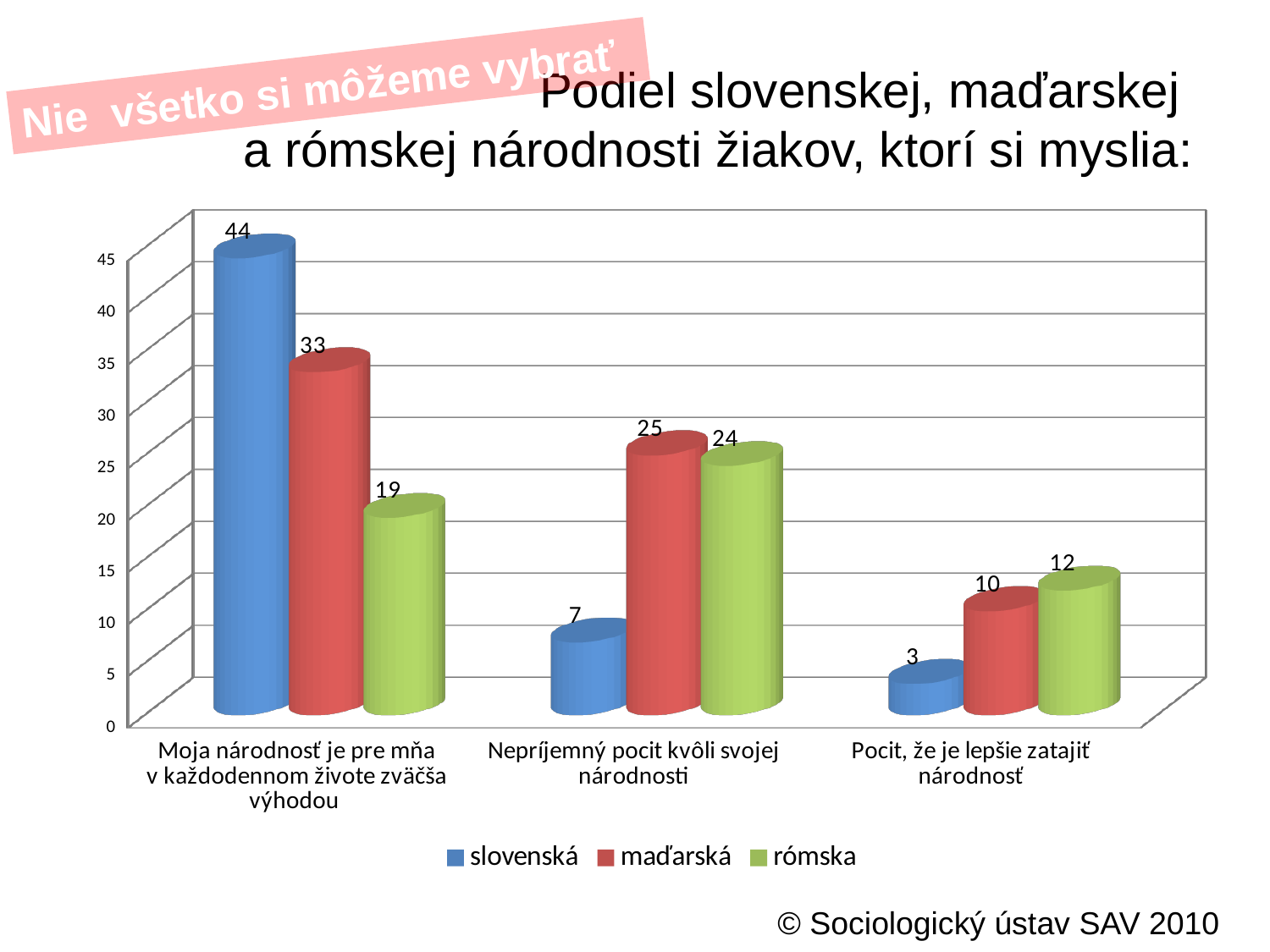
What is the difference between the slovenská and rómska values in the category 'Moja národnosť je pre mňa v každodennom živote zväčša výhodou'? 25 Which series has the lowest value in the category 'Pocit, že je lepšie zatajiť národnosť'? slovenská What value is shown for maďarská in the category 'Pocit, že je lepšie zatajiť národnosť'? 10 Which is larger: the rómska value for 'Pocit, že je lepšie zatajiť národnosť' or the slovenská value for 'Nepríjemný pocit kvôli svojej národnosti'? rómska value for 'Pocit, že je lepšie zatajiť národnosť' Which colour represents the maďarská series in the chart? red What kind of chart is shown on the slide? bar chart What value is shown for slovenská in the category 'Moja národnosť je pre mňa v každodennom živote zväčša výhodou'? 44 How many series does the legend list? 3 How many categories are shown on the x axis? 3 What value is shown for rómska in the category 'Nepríjemný pocit kvôli svojej národnosti'? 24 What is the difference between the maďarská and slovenská values in the category 'Nepríjemný pocit kvôli svojej národnosti'? 18 Which series has the highest value in the category 'Moja národnosť je pre mňa v každodennom živote zväčša výhodou'? slovenská